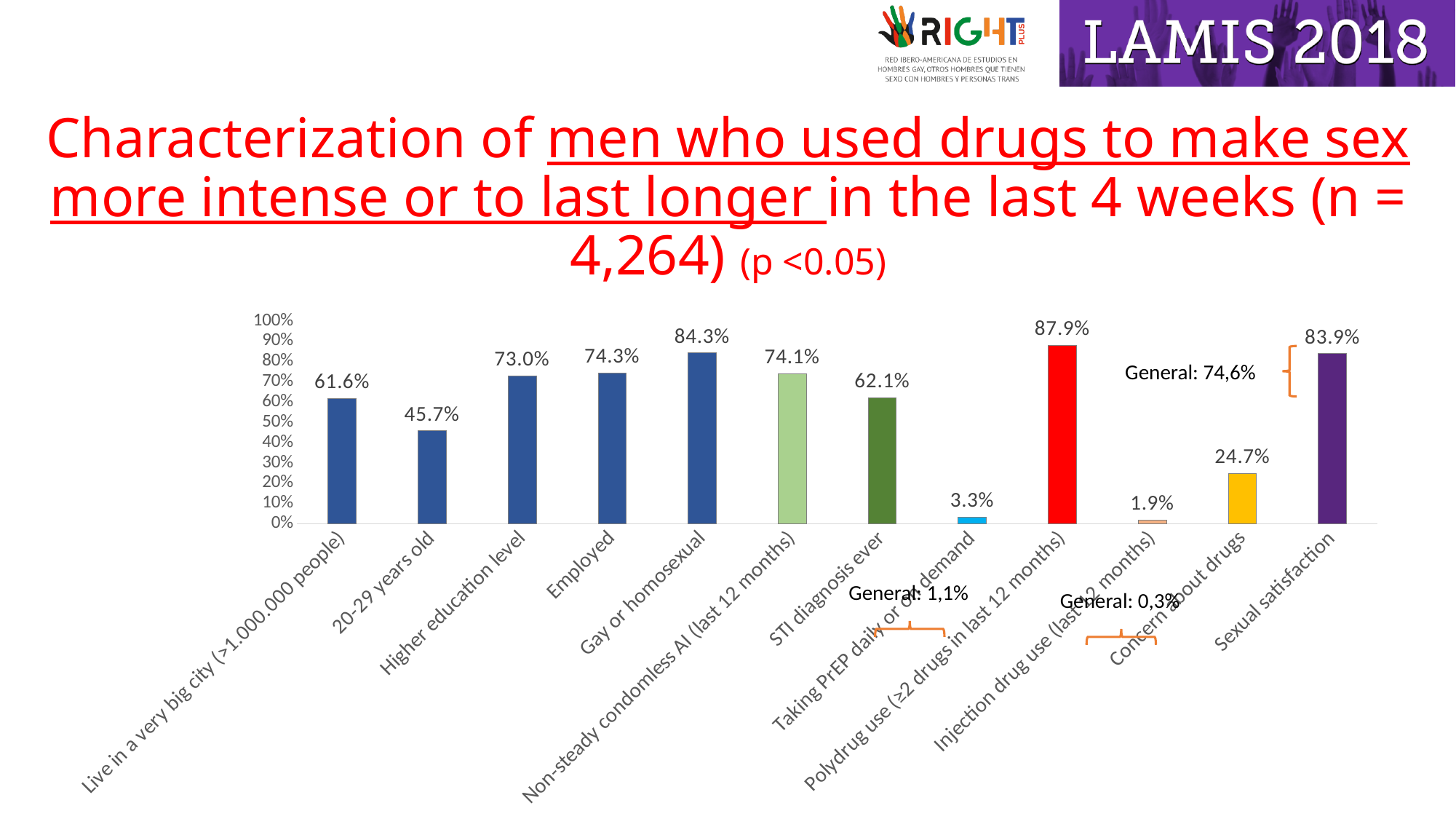
Which is larger: 'Live in a very big city (>1.000.000 people)' or 'STI diagnosis ever'? STI diagnosis ever What kind of chart is shown on the slide? bar chart What is the value for 'Injection drug use (last 12 months)'? 1.9% Is the value for 'Concern about drugs' greater or less than 30%? less How many categories are shown in the chart? 12 What is the value for 'Sexual satisfaction'? 83.9% What is the difference between 'Employed' and 'Higher education level'? 1.3% Which category has the highest value? Polydrug use (≥2 drugs in last 12 months) What is the value for '20-29 years old'? 45.7% What is the 'General' value annotated next to the 'Sexual satisfaction' bar? 74,6% Which category has the lowest value? Injection drug use (last 12 months) What is the value for 'Gay or homosexual'? 84.3%